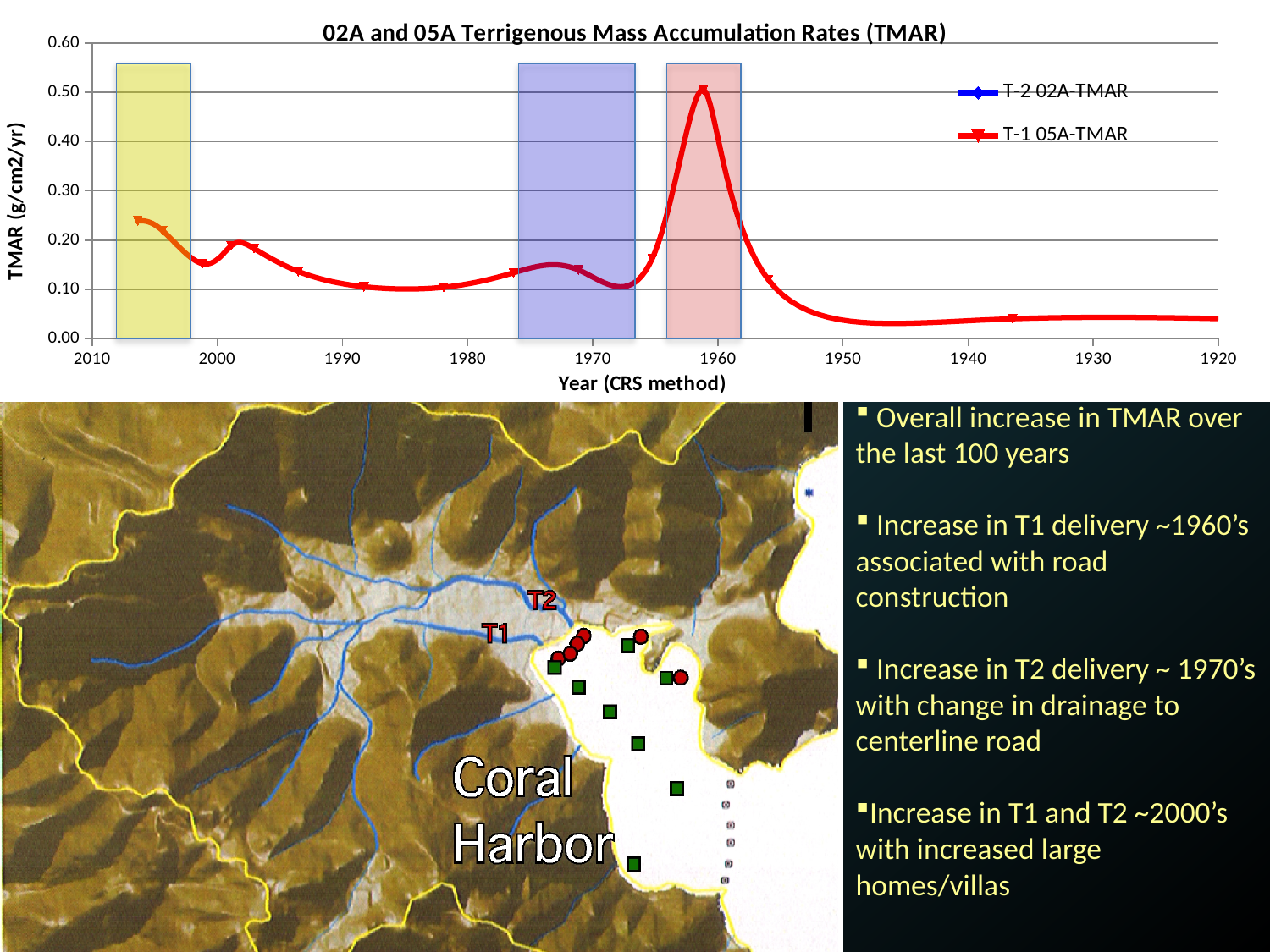
In the TMAR chart, which is larger for the T-1 05A-TMAR series: the value near 2000 or the value near 1940? near 2000 In the TMAR chart, is the T-1 05A-TMAR value near 1940 greater or less than 0.10? less What is the label of the y axis of the TMAR chart? TMAR (g/cm2/yr) In the TMAR chart, is the T-1 05A-TMAR value near 1990 greater or less than 0.20? less What is the highest value shown on the y axis of the TMAR chart? 0.60 In the TMAR chart, moving along the x axis from 1970 toward 1960, does the T-1 05A-TMAR line rise or fall? rise In the TMAR chart, is the T-1 05A-TMAR value near 2006 greater or less than 0.20? greater What is the title of the chart at the top of the slide? 02A and 05A Terrigenous Mass Accumulation Rates (TMAR) In the TMAR chart, which is larger for the T-1 05A-TMAR series: the value near 1960 or the value near 1990? near 1960 What kind of chart is shown at the top of the slide? line chart How many series does the legend of the TMAR chart list? 2